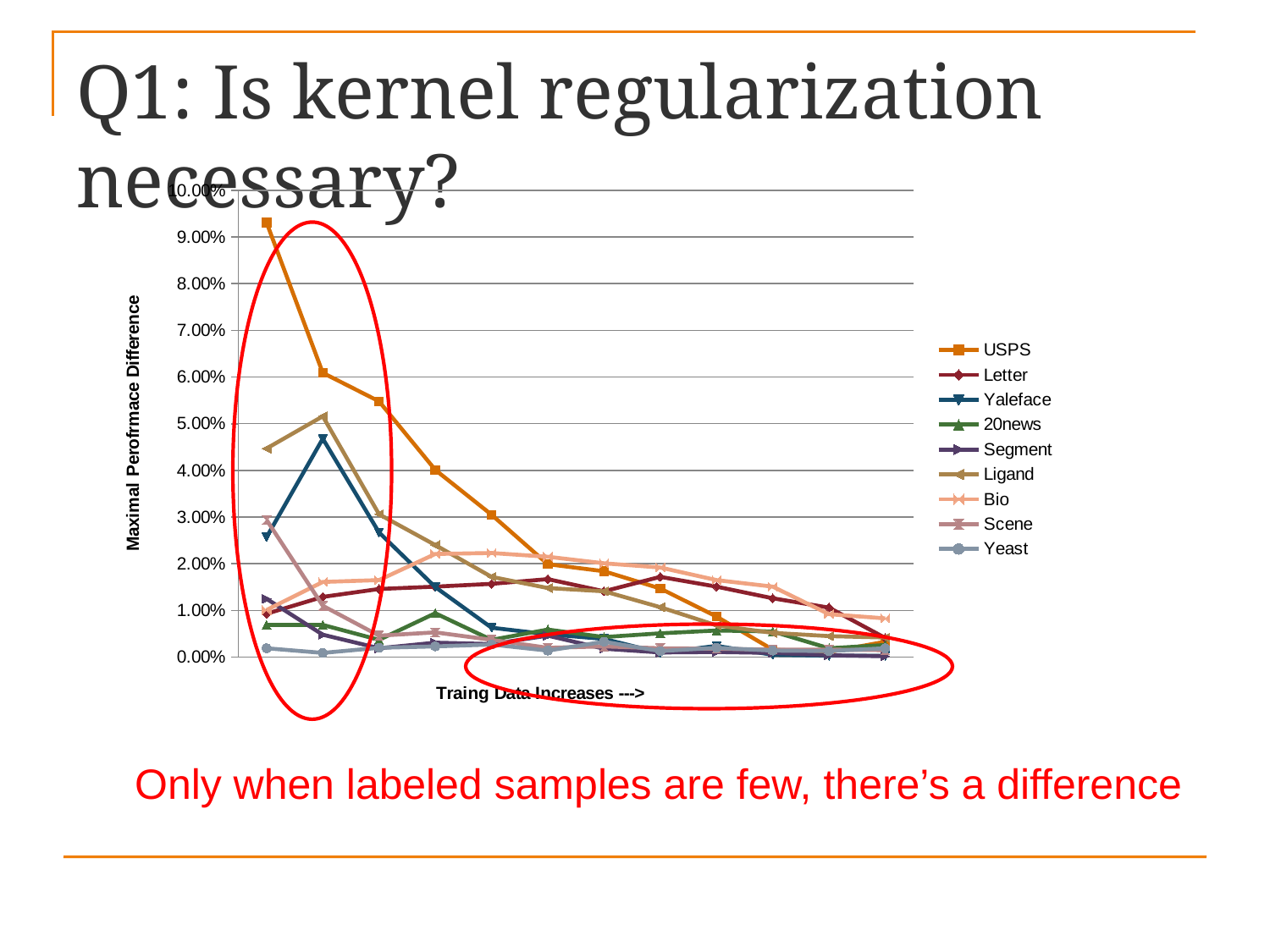
What is the label of the y axis? Maximal Perofrmace Difference What kind of chart is shown on the slide? line chart Is the peak value of the Yaleface series greater or less than 4.00%? greater Which series has the lowest value at the leftmost point of the x axis? Yeast At the leftmost point of the x axis, which series has the larger value, Scene or 20news? Scene Does the USPS series generally rise or fall as training data increases along the x axis? fall Is the first (leftmost) value of the Yeast series greater or less than 1.00%? less What is the label of the x axis? Traing Data Increases ---> How many series does the legend list? 9 Which series has the highest value at the leftmost point of the x axis? USPS Is the first (leftmost) value of the USPS series greater or less than 9.00%? greater At the leftmost point of the x axis, which series has the larger value, USPS or Ligand? USPS